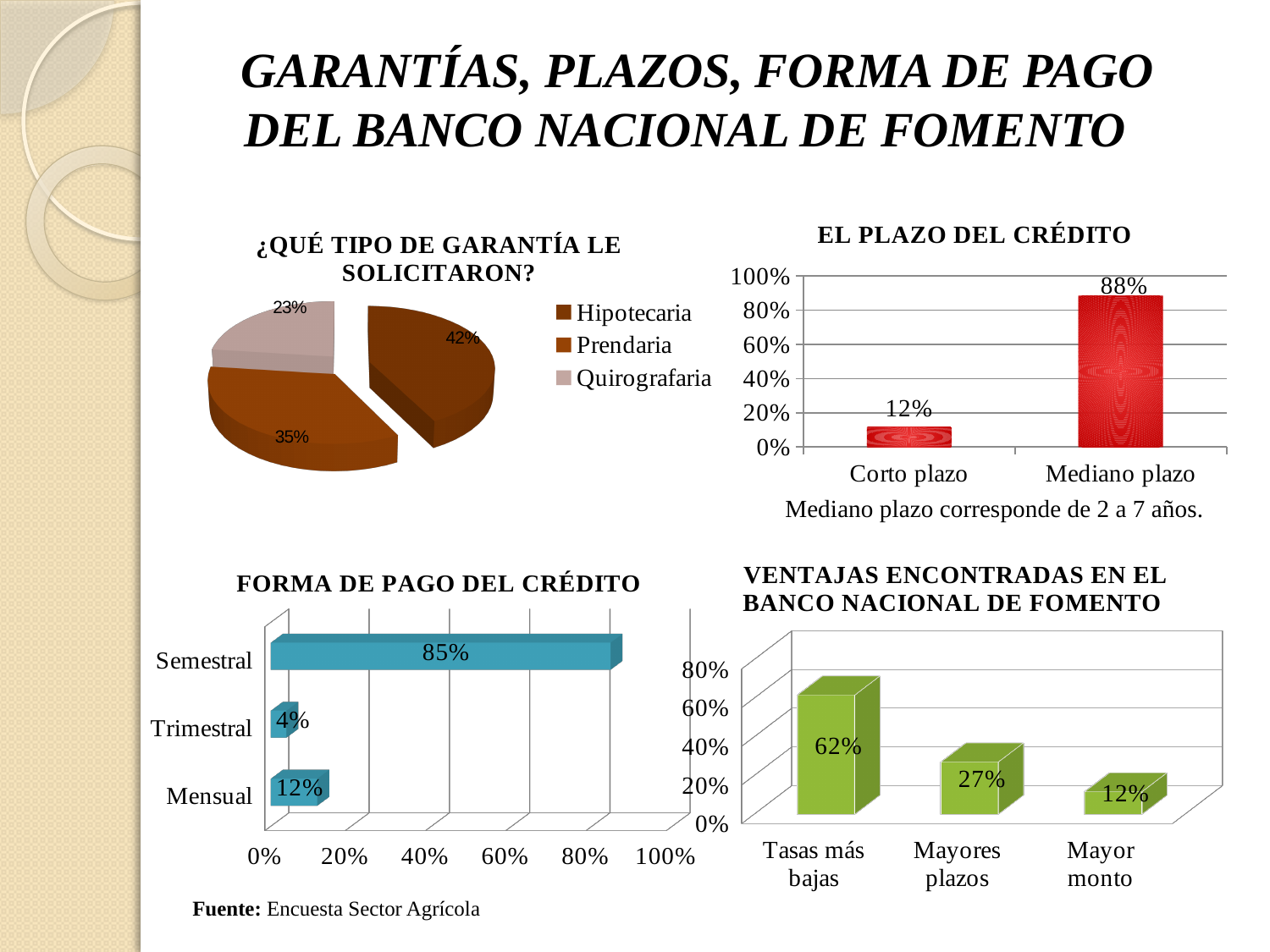
In the chart 'EL PLAZO DEL CRÉDITO', what is the value for Mediano plazo? 88% In the chart 'VENTAJAS ENCONTRADAS EN EL BANCO NACIONAL DE FOMENTO', do the values rise or fall from left to right? Fall What kind of chart is 'FORMA DE PAGO DEL CRÉDITO'? Bar chart In the chart 'VENTAJAS ENCONTRADAS EN EL BANCO NACIONAL DE FOMENTO', what is the value for Mayores plazos? 27% In the chart 'VENTAJAS ENCONTRADAS EN EL BANCO NACIONAL DE FOMENTO', which category has the highest value? Tasas más bajas In the pie chart '¿QUÉ TIPO DE GARANTÍA LE SOLICITARON?', which is larger, Hipotecaria or Prendaria? Hipotecaria In the pie chart '¿QUÉ TIPO DE GARANTÍA LE SOLICITARON?', what share does Quirografaria have? 23% In the chart 'FORMA DE PAGO DEL CRÉDITO', what is the value for Semestral? 85% In the chart 'EL PLAZO DEL CRÉDITO', what is the difference between Mediano plazo and Corto plazo? 76% In the chart 'FORMA DE PAGO DEL CRÉDITO', how many categories are shown? 3 How many entries does the legend of the pie chart '¿QUÉ TIPO DE GARANTÍA LE SOLICITARON?' list? 3 In the chart 'FORMA DE PAGO DEL CRÉDITO', which category has the lowest value? Trimestral